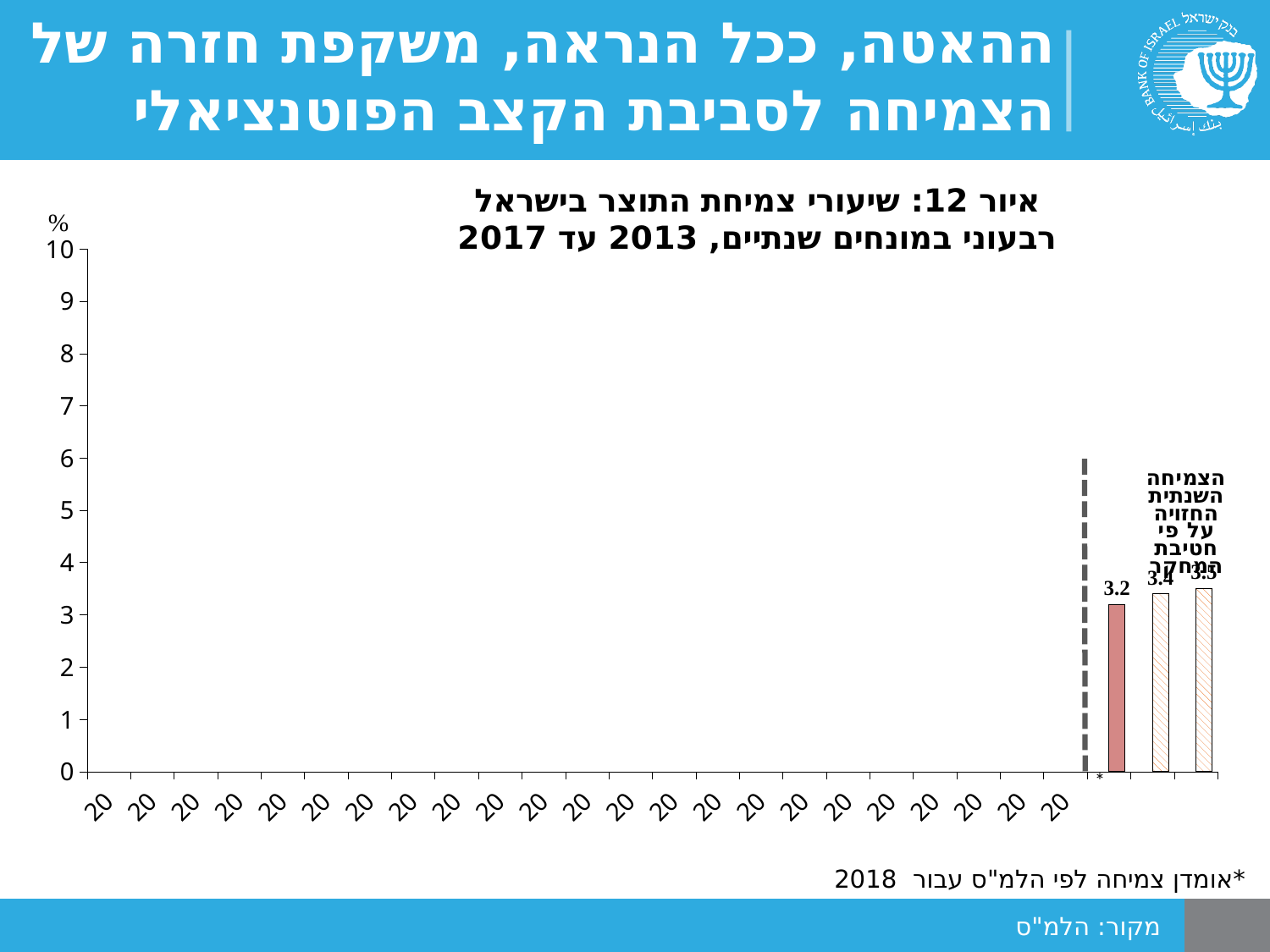
Is the value of the solid red bar greater or less than 4? less What is the highest value shown on the vertical axis of the chart? 10 Which of the three labelled bars has the highest value? the rightmost bar (3.5) Which of the three labelled bars has the lowest value? the solid red bar (3.2) What kind of chart is shown on the slide? bar chart What is the value printed above the rightmost bar of the chart? 3.5 How many bars on the chart have a printed data label? 3 What is the value printed above the middle of the three labelled bars at the right of the chart? 3.4 What is the difference between the two hatched bars, 3.5 and 3.4? 0.1 What is the value printed above the solid red bar at the right of the chart? 3.2 Which is larger, the value of the solid red bar or the value of the rightmost hatched bar? the rightmost hatched bar What is the difference between the rightmost bar (3.5) and the solid red bar (3.2)? 0.3